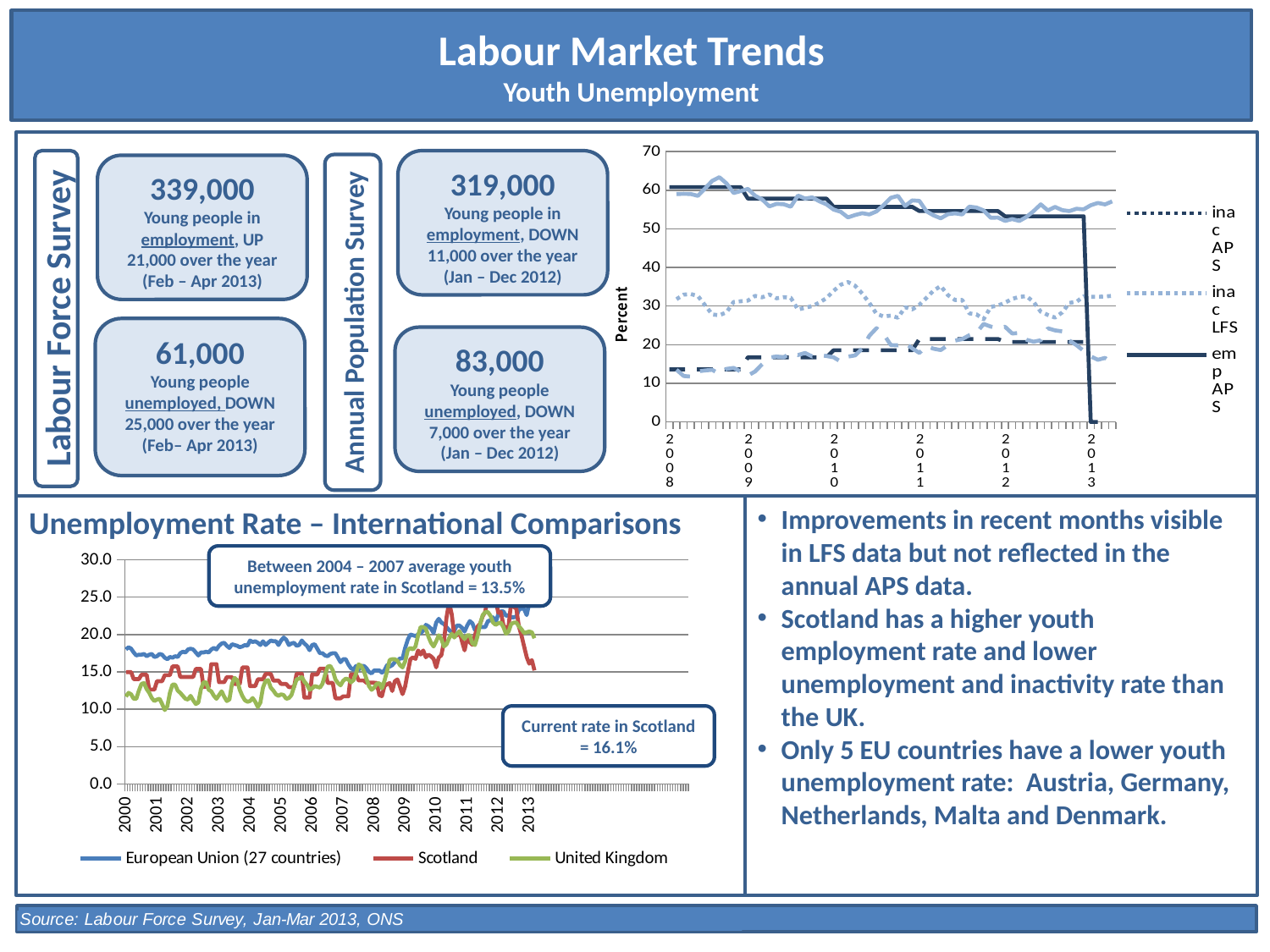
In the 'Unemployment Rate – International Comparisons' chart, which is larger in 2000: the European Union (27 countries) value or the Scotland value? European Union (27 countries) In the 'Unemployment Rate – International Comparisons' chart, which series has the highest value in 2000? European Union (27 countries) What kind of chart is the 'Unemployment Rate – International Comparisons' chart? Line chart According to the annotation on the 'Unemployment Rate – International Comparisons' chart, what is the current youth unemployment rate in Scotland? 16.1% What kind of chart is the chart in the top right of the slide with the 'Percent' axis? Line chart In the 'Unemployment Rate – International Comparisons' chart, is the United Kingdom value in 2001 greater or less than 15.0? less According to the annotation on the 'Unemployment Rate – International Comparisons' chart, what was the average youth unemployment rate in Scotland between 2004 and 2007? 13.5% In the top-right chart with the 'Percent' axis, does the 'emp APS' line rise or fall from 2008 to 2012? fall In the 'Unemployment Rate – International Comparisons' chart, is the European Union (27 countries) value in 2000 greater or less than 15.0? greater In the top-right chart with the 'Percent' axis, is the 'inac APS' value in 2008 greater or less than 40? less How many series does the legend of the 'Unemployment Rate – International Comparisons' chart list? 3 Which series are listed in the legend of the 'Unemployment Rate – International Comparisons' chart? European Union (27 countries), Scotland, United Kingdom